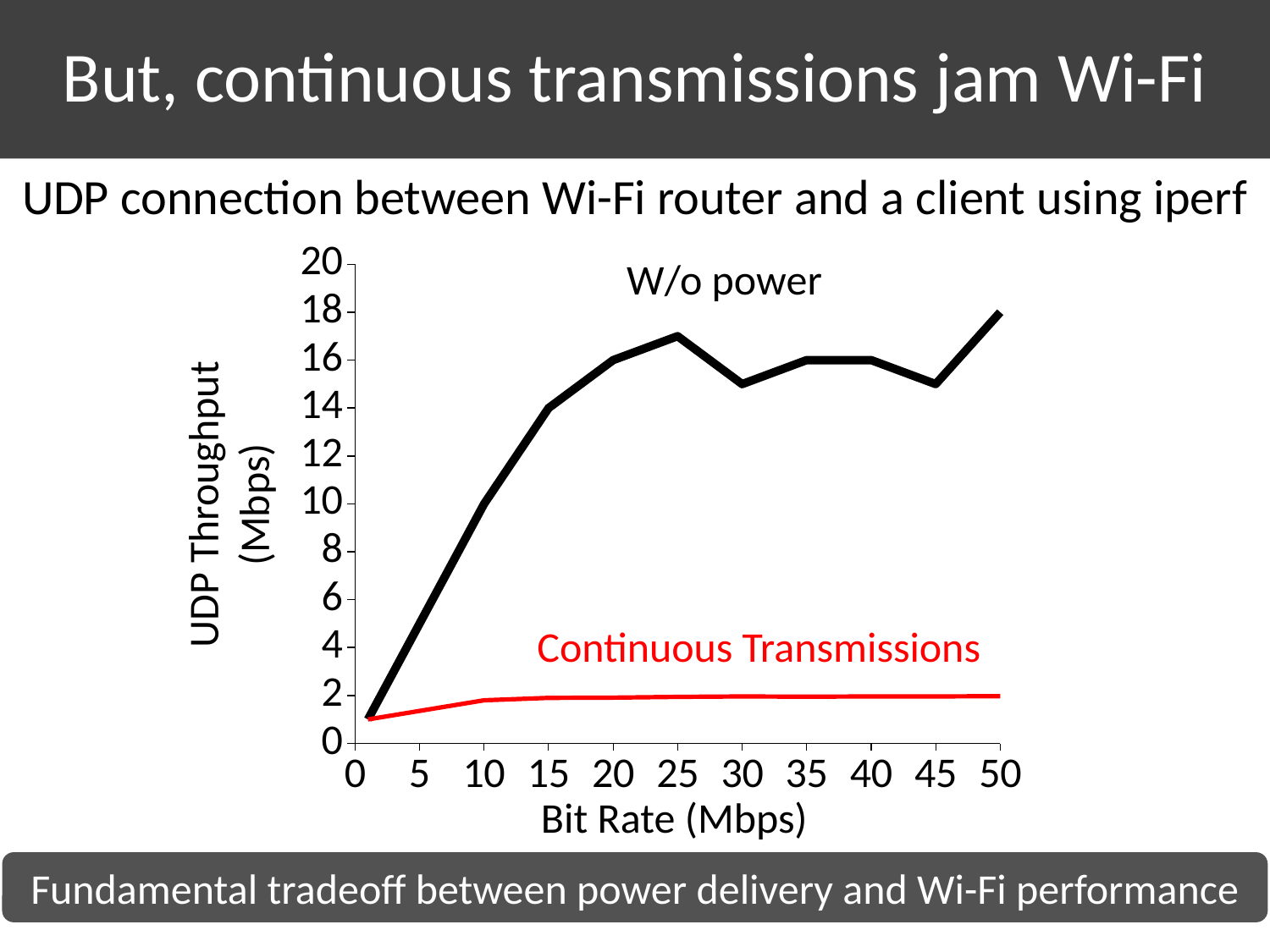
How many series are plotted on the chart? 2 Which series has the higher UDP throughput at a bit rate of 30 Mbps, W/o power or Continuous Transmissions? W/o power Is the UDP throughput for Continuous Transmissions at a bit rate of 10 Mbps greater or less than 4? less Is the UDP throughput for W/o power at a bit rate of 50 Mbps greater or less than 16? greater What is the label of the x axis? Bit Rate (Mbps) Is the UDP throughput for W/o power at a bit rate of 5 Mbps greater or less than 8? less What is the label of the y axis? UDP Throughput (Mbps) What type of chart is shown on the slide? line chart Does the W/o power series generally rise or fall as bit rate increases from 0 to 20 Mbps? rise Which series is drawn in red? Continuous Transmissions